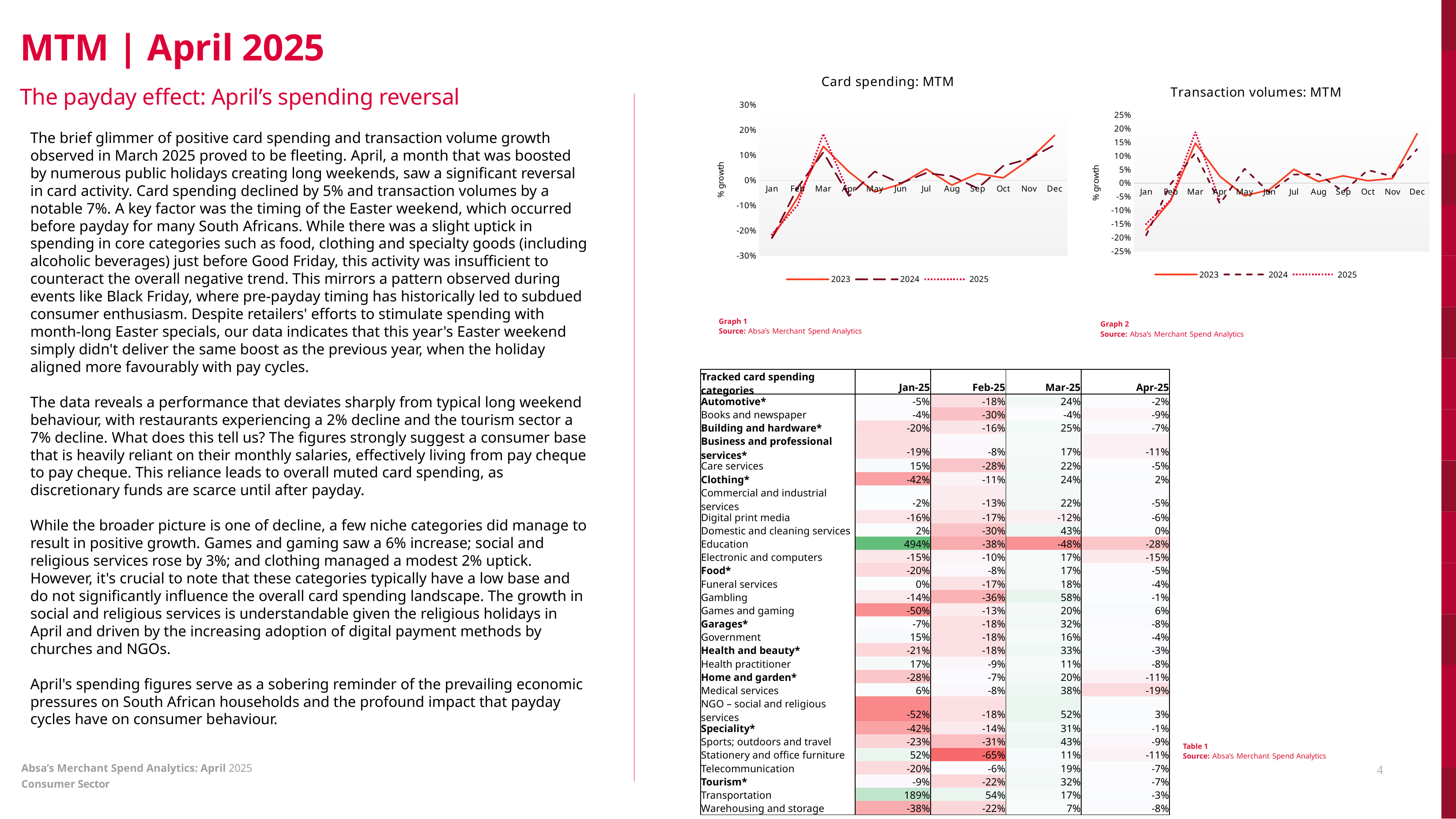
In the "Card spending: MTM" chart, is the 2023 value for Dec greater or less than 10%? greater In the "Card spending: MTM" chart, is the 2023 value for Jan greater or less than -10%? less What is the title of the chart on the right of the slide? Transaction volumes: MTM In the "Transaction volumes: MTM" chart, does the 2023 line rise or fall from Nov to Dec? rise How many series does the legend of the "Transaction volumes: MTM" chart list? 3 What kind of chart is the "Card spending: MTM" chart? line chart In the "Transaction volumes: MTM" chart, is the 2023 value for Dec greater or less than 10%? greater In the "Card spending: MTM" chart, which is larger for 2023: the value for Jan or the value for Dec? Dec How many months are shown on the x axis of the "Card spending: MTM" chart? 12 In the "Card spending: MTM" chart, which month has the highest 2023 value? Dec In the "Card spending: MTM" chart, which month has the lowest 2023 value? Jan